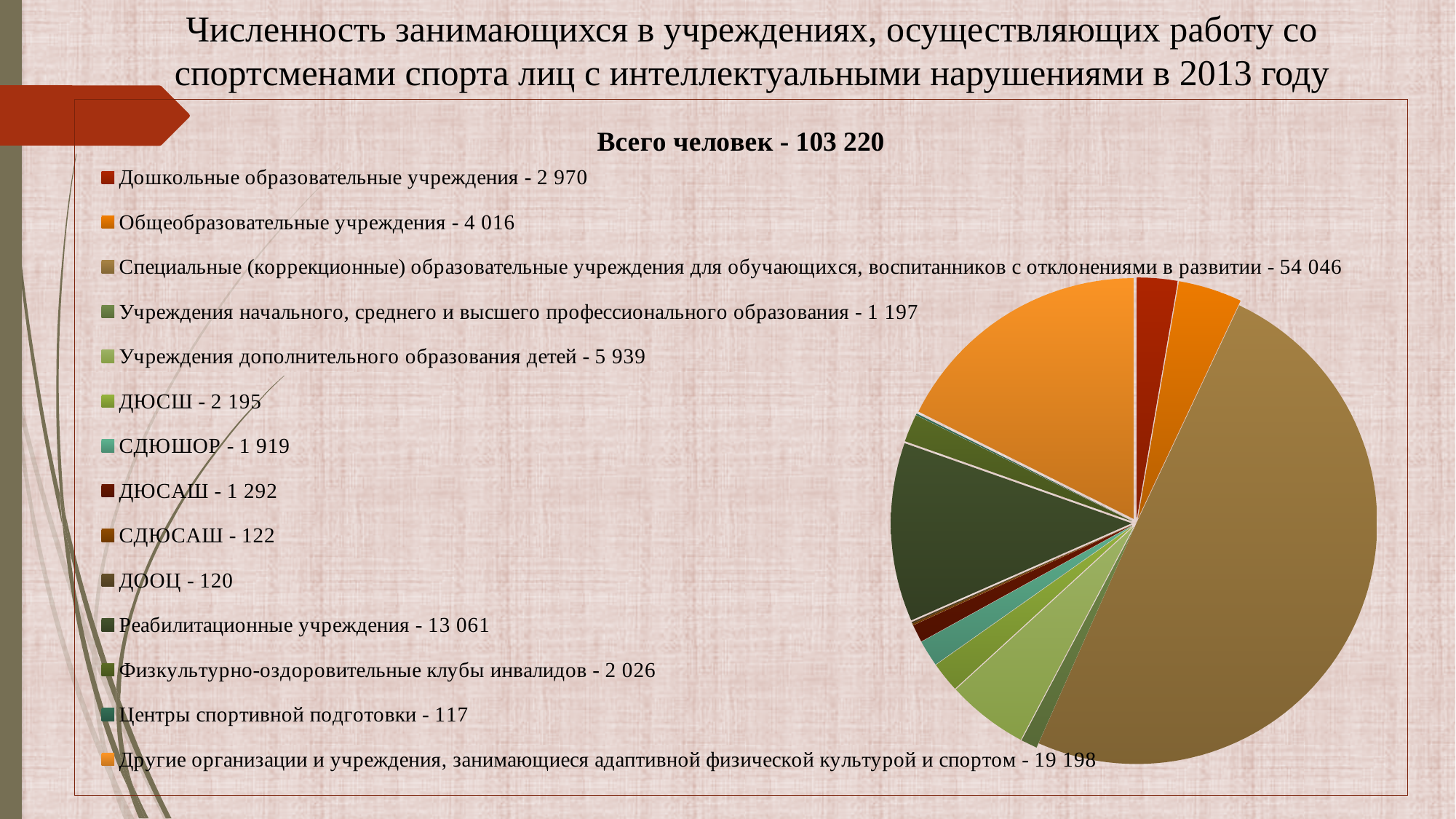
What kind of chart is shown on the slide? pie chart What is the value for Реабилитационные учреждения? 13 061 What total number of people is stated above the chart? 103 220 What is the difference between the values for Другие организации и учреждения, занимающиеся адаптивной физической культурой и спортом and Реабилитационные учреждения? 6 137 Which category has the highest value? Специальные (коррекционные) образовательные учреждения для обучающихся, воспитанников с отклонениями в развитии Which category has the lowest value? Центры спортивной подготовки Which is larger, the value for ДЮСШ or the value for СДЮШОР? ДЮСШ What year does the chart title refer to? 2013 What is the difference between the values for Общеобразовательные учреждения and Дошкольные образовательные учреждения? 1 046 What is the value for Учреждения дополнительного образования детей? 5 939 How many categories does the pie chart have? 14 What is the value for ДЮСАШ? 1 292